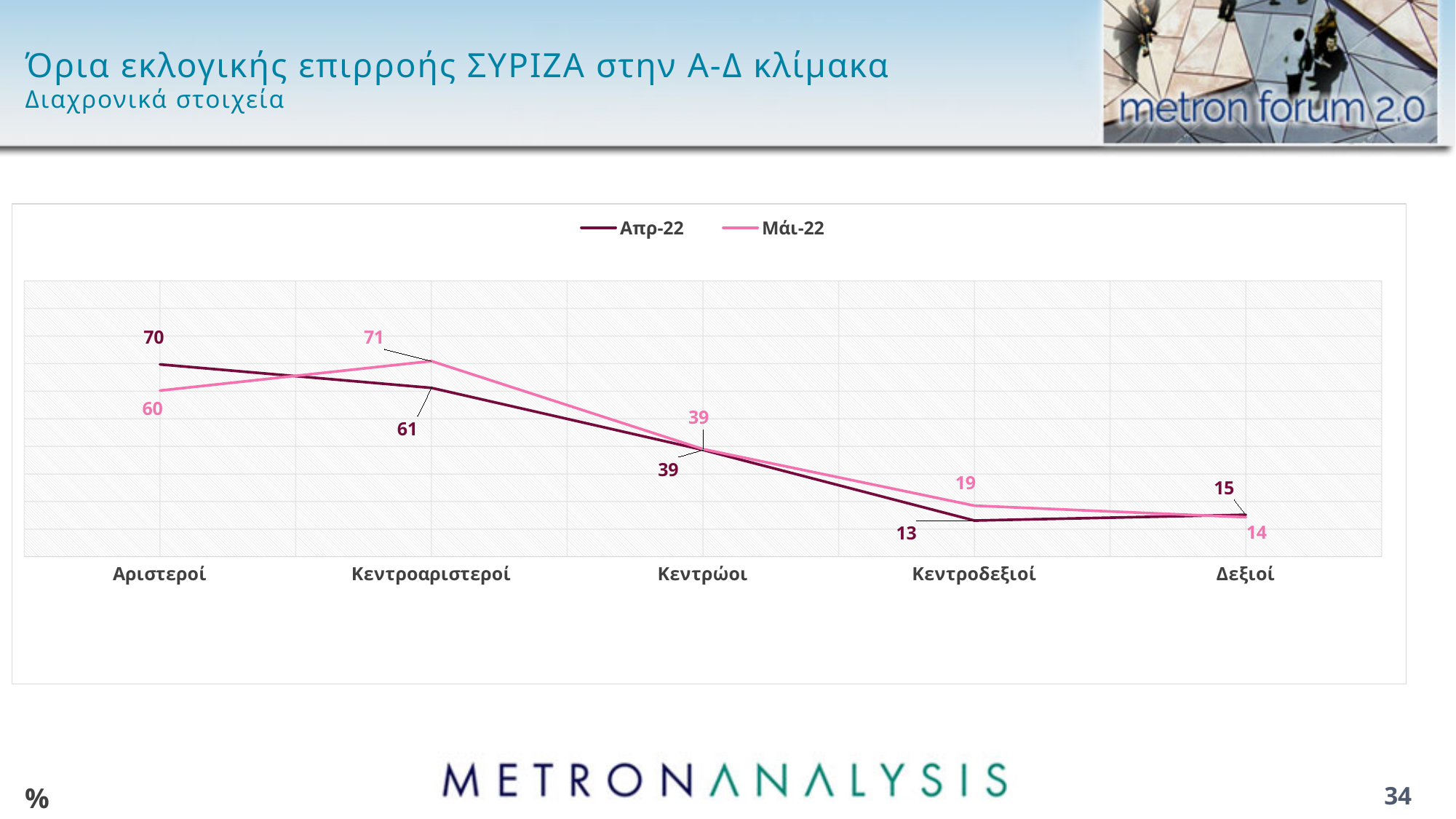
What kind of chart is shown on the slide? Line chart What is the value for Δεξιοί in the Μάι-22 series? 14 How many categories are shown on the x axis? 5 Which series has the larger value for Κεντροαριστεροί, Απρ-22 or Μάι-22? Μάι-22 Do the Απρ-22 values generally rise or fall from Αριστεροί to Κεντροδεξιοί? Fall Which category has the highest value in the Μάι-22 series? Κεντροαριστεροί What is the value for Κεντροαριστεροί in the Μάι-22 series? 71 Which category has the lowest value in the Απρ-22 series? Κεντροδεξιοί How many series does the legend list? 2 What is the value for Κεντροδεξιοί in the Απρ-22 series? 13 What is the value for Αριστεροί in the Απρ-22 series? 70 What is the difference between the Απρ-22 and Μάι-22 values for Αριστεροί? 10